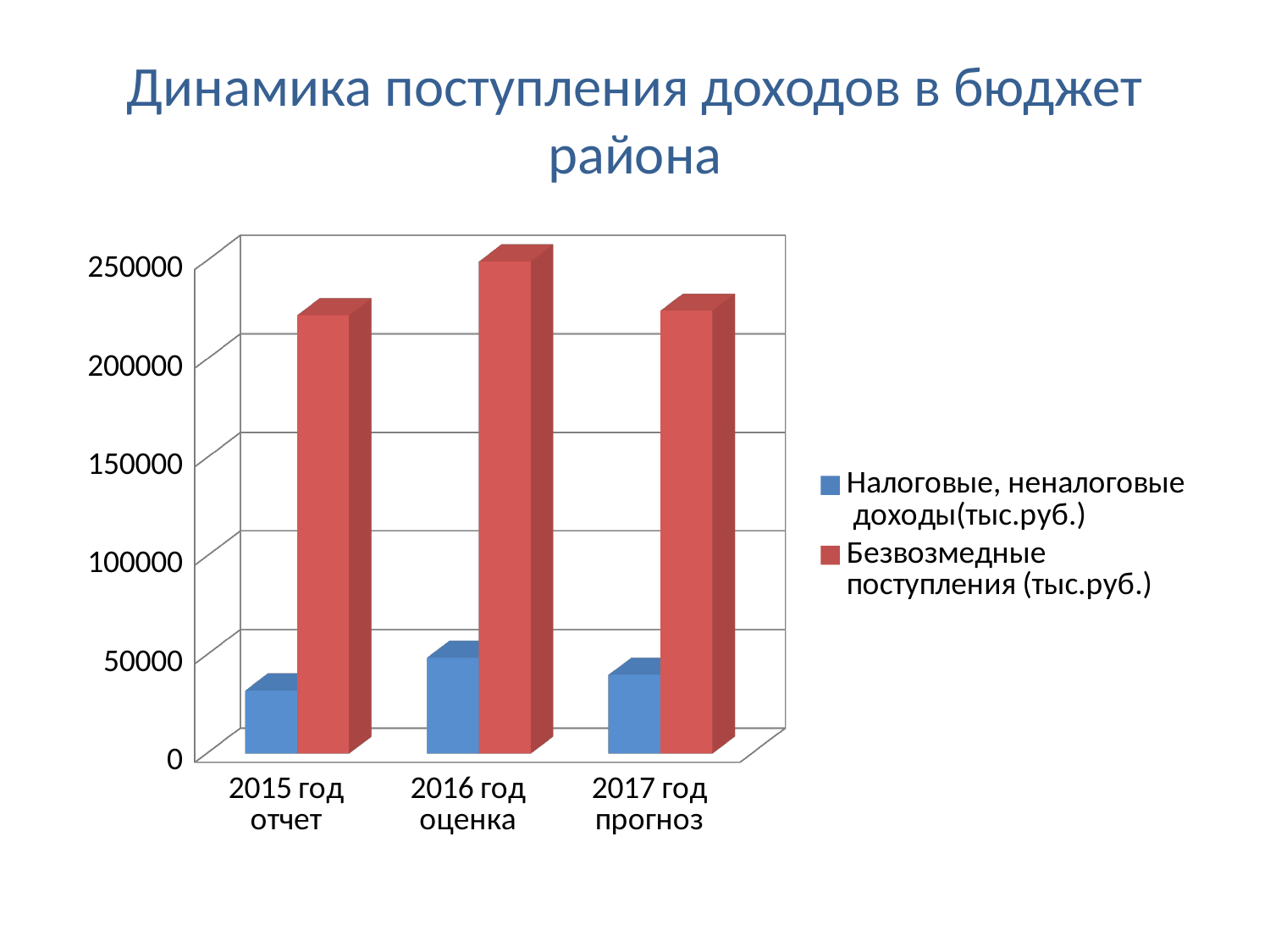
Is the value for Безвозмедные поступления (тыс.руб.) in 2016 год оценка greater or less than 200000? greater How many series does the legend list? 2 Which series is shown in red? Безвозмедные поступления (тыс.руб.) In which category is the value for Налоговые, неналоговые доходы(тыс.руб.) lowest? 2015 год отчет What is the title of the chart? Динамика поступления доходов в бюджет района In which category is the value for Налоговые, неналоговые доходы(тыс.руб.) highest? 2016 год оценка Which is larger: Безвозмедные поступления (тыс.руб.) in 2016 год оценка or in 2015 год отчет? 2016 год оценка In which category is the value for Безвозмедные поступления (тыс.руб.) highest? 2016 год оценка Is the value for Безвозмедные поступления (тыс.руб.) in 2015 год отчет greater or less than 250000? less What type of chart is shown on the slide? bar chart How many categories are shown on the x axis? 3 Is the value for Налоговые, неналоговые доходы(тыс.руб.) in 2015 год отчет greater or less than 50000? less